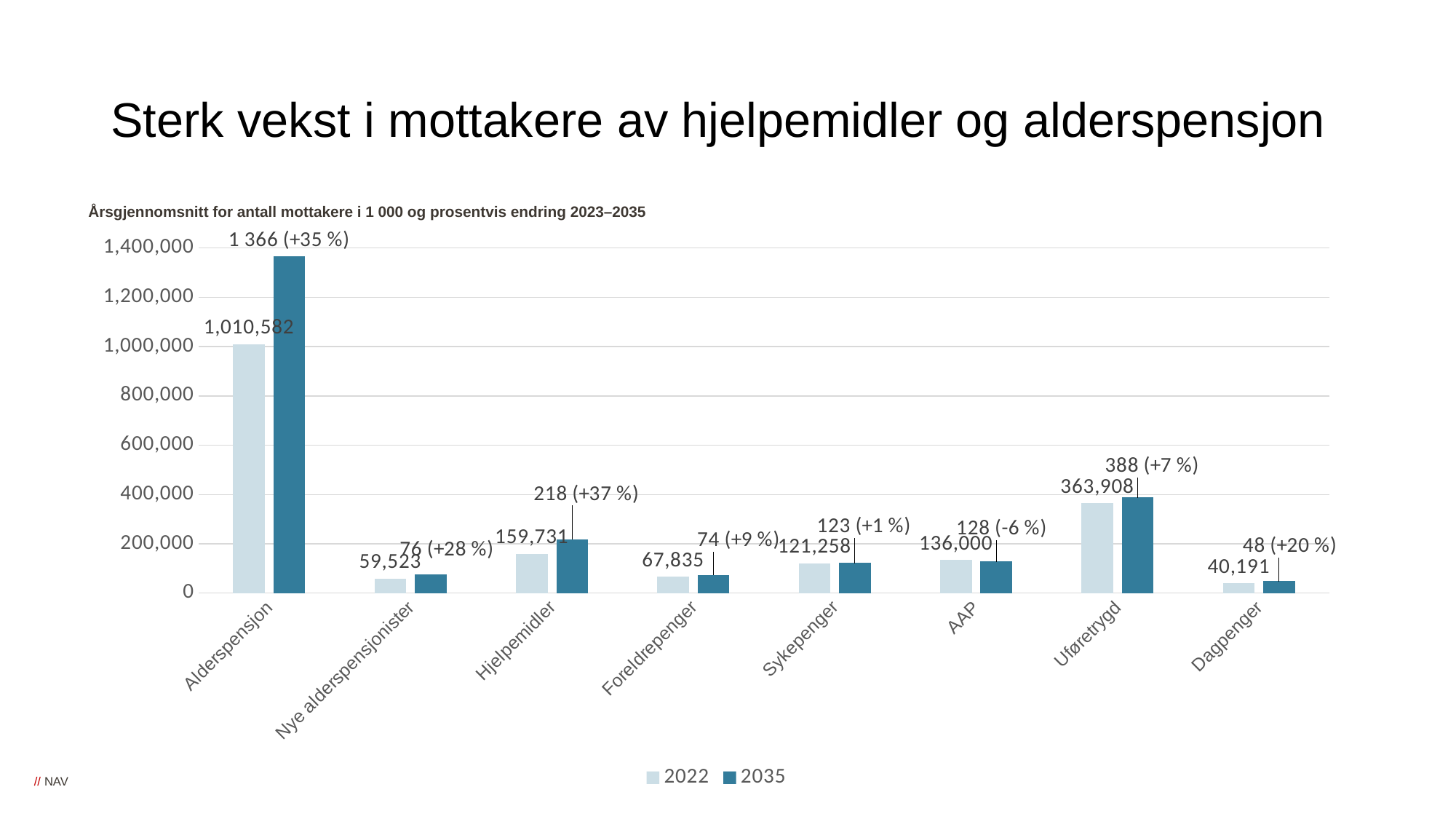
What is the 2022 value for Uføretrygd? 363,908 How many series does the legend list? 2 What data label is shown on the 2035 bar for Hjelpemidler? 218 (+37 %) What percentage change is shown for Dagpenger between 2023 and 2035? +20 % What is the difference between the 2022 values for Uføretrygd and AAP? 227,908 How many categories are shown on the x axis? 8 Which is larger in 2022: Sykepenger or AAP? AAP Is the 2035 value for Alderspensjon greater or less than 1,200,000? greater What kind of chart is shown on the slide? Bar chart Which category has the highest 2022 value? Alderspensjon What is the 2022 value for Alderspensjon? 1,010,582 Which category has the lowest 2022 value? Dagpenger